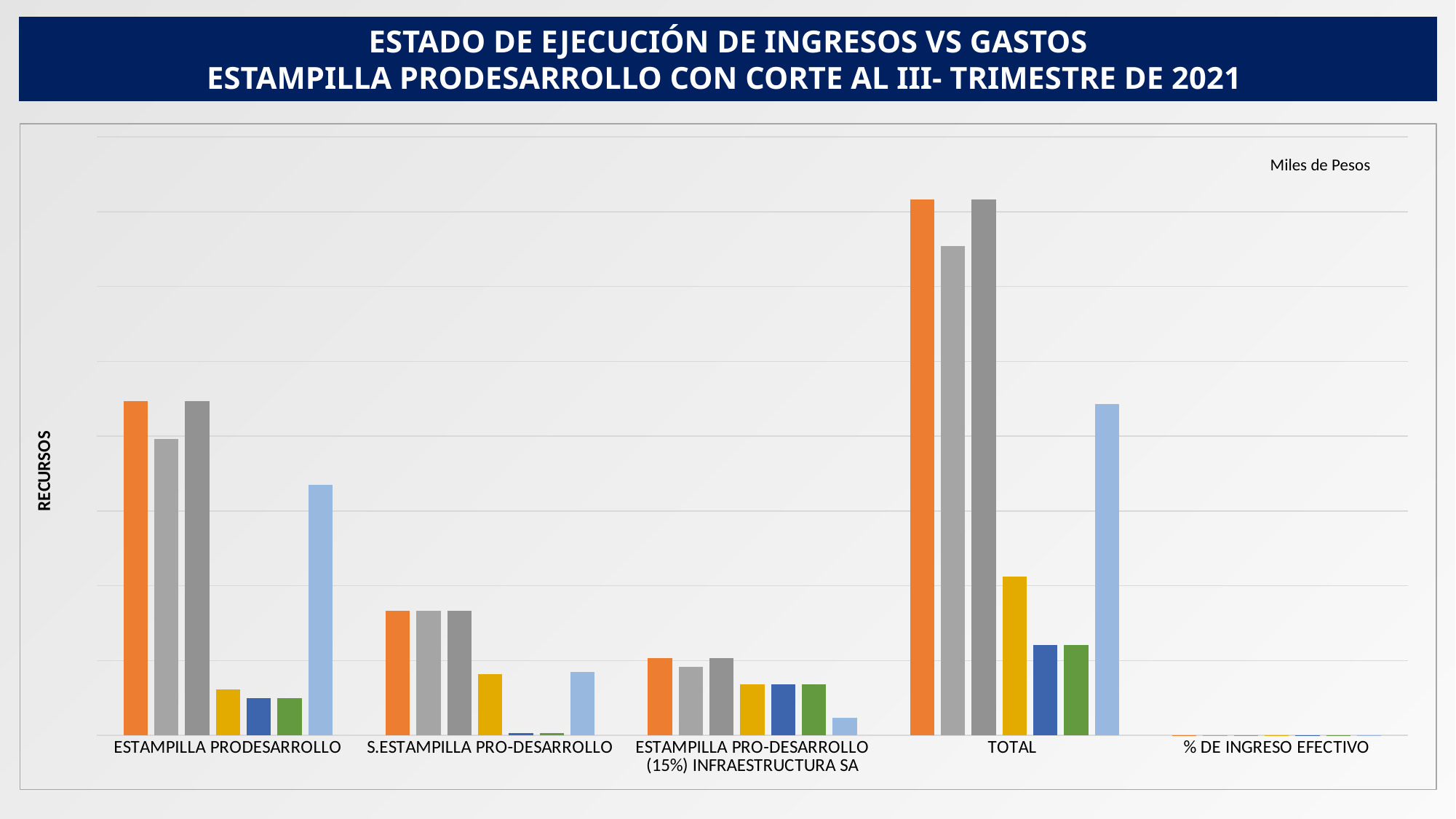
What is the label on the vertical axis of the chart? RECURSOS Which category has the smallest bars in the chart? % DE INGRESO EFECTIVO Within the ESTAMPILLA PRODESARROLLO category, is the light blue bar taller or shorter than the yellow bar? Taller What unit note is shown in the top right corner of the chart area? Miles de Pesos Within the TOTAL category, is the yellow bar taller or shorter than the light blue bar? Shorter How many bars are plotted for the TOTAL category? 7 Is the orange bar for ESTAMPILLA PRODESARROLLO taller or shorter than the orange bar for S.ESTAMPILLA PRO-DESARROLLO? Taller How many categories are shown along the x axis of the chart? 5 Which category has the tallest bars in the chart? TOTAL What kind of chart is shown on the slide? Bar chart